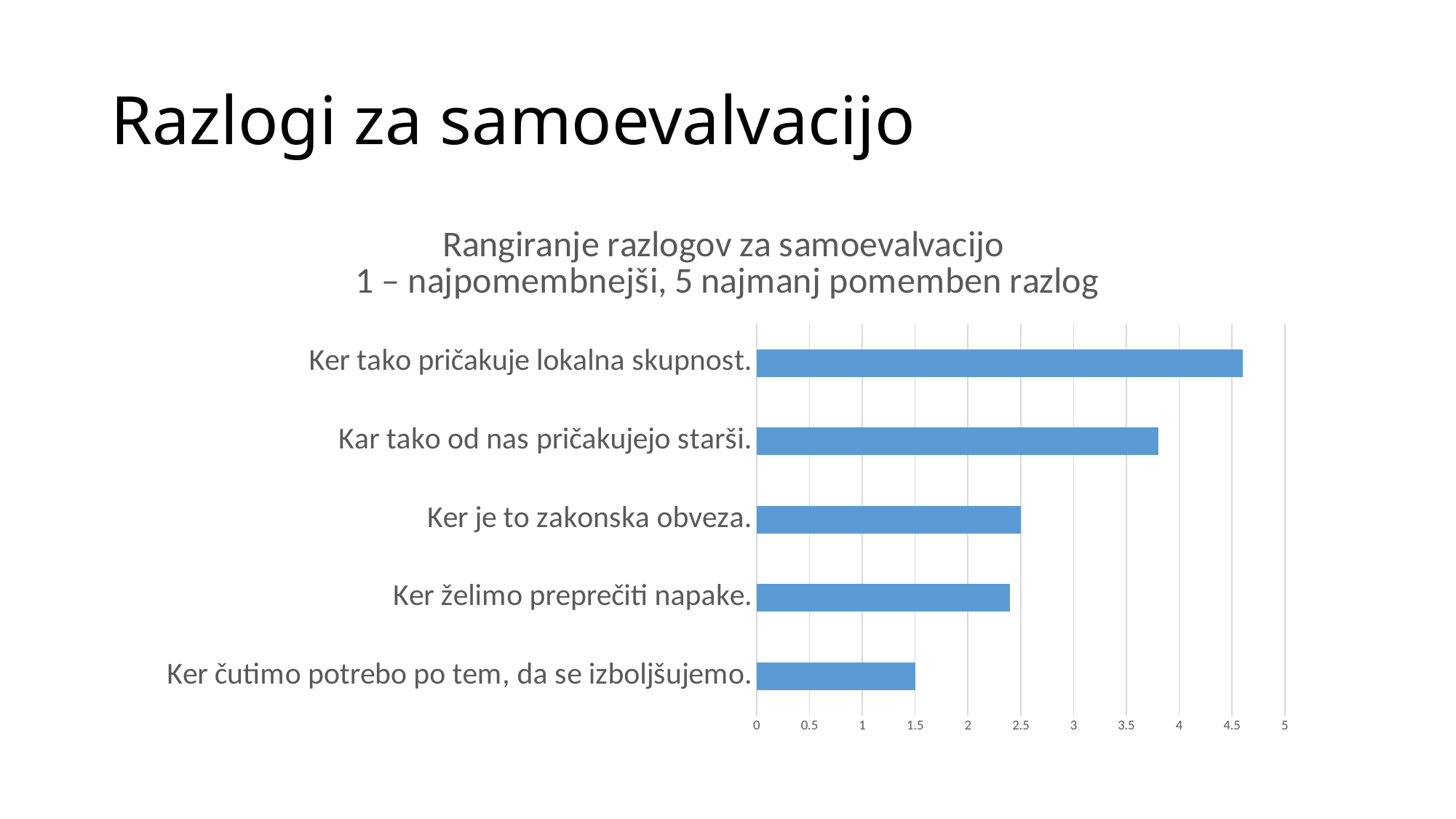
Which category has the shortest bar in the chart? Ker čutimo potrebo po tem, da se izboljšujemo. What is the highest value shown on the horizontal axis of the chart? 5 Is the value for "Ker čutimo potrebo po tem, da se izboljšujemo." greater or less than 2? less How many categories (reasons) are plotted in the chart? 5 Which has the larger value: "Ker želimo preprečiti napake." or "Ker čutimo potrebo po tem, da se izboljšujemo."? Ker želimo preprečiti napake. Is the value for "Kar tako od nas pričakujejo starši." greater or less than 3.5? greater Is the value for "Ker tako pričakuje lokalna skupnost." greater or less than 4.5? greater Which has the larger value: "Kar tako od nas pričakujejo starši." or "Ker je to zakonska obveza."? Kar tako od nas pričakujejo starši. What is the title of the chart? Rangiranje razlogov za samoevalvacijo 1 – najpomembnejši, 5 najmanj pomemben razlog What kind of chart is shown on the slide? bar chart Which category has the longest bar in the chart? Ker tako pričakuje lokalna skupnost.